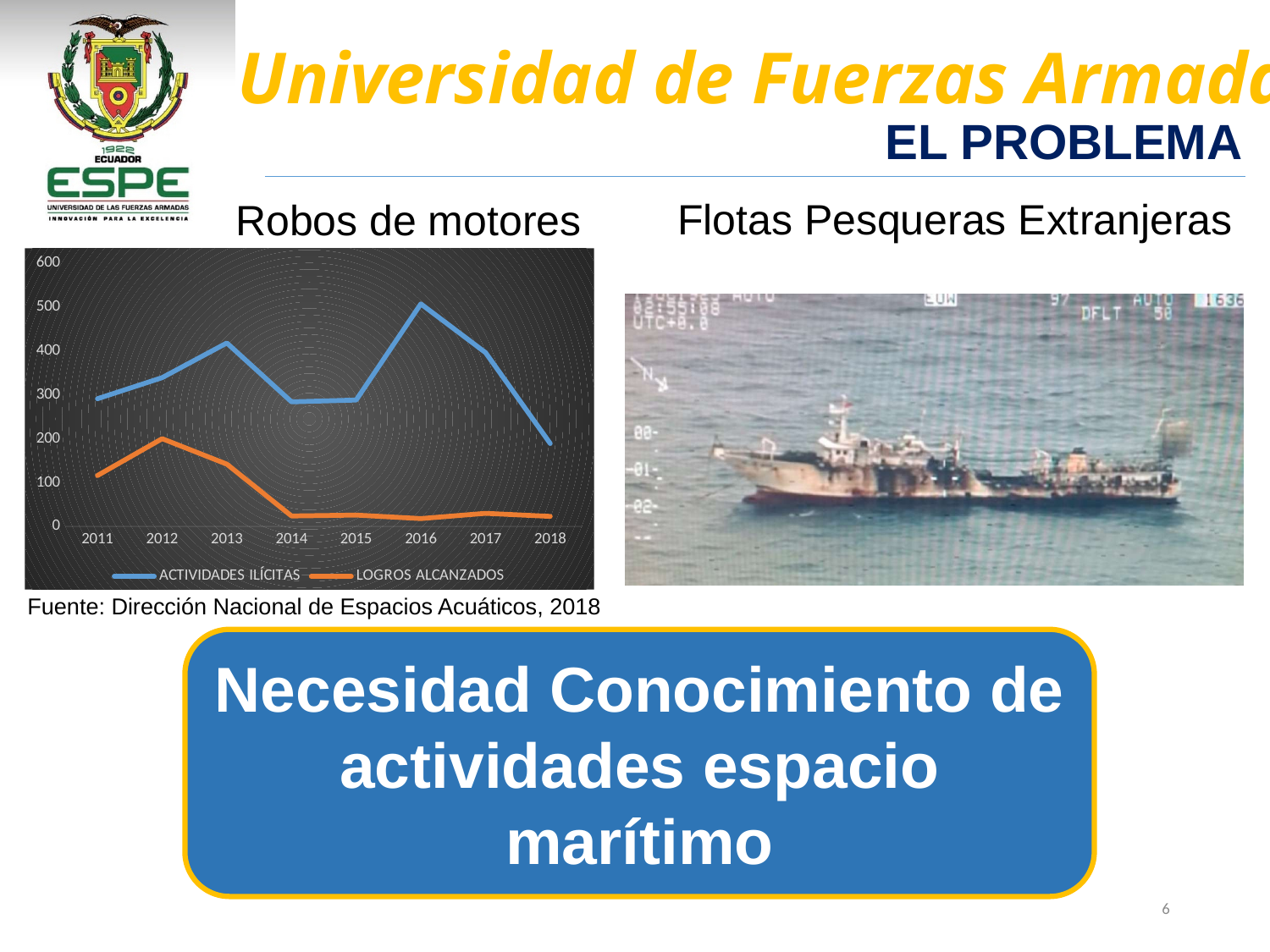
What kind of chart is shown under the heading "Robos de motores"? line chart How many series does the legend of the "Robos de motores" chart list? 2 In the "Robos de motores" chart, does the ACTIVIDADES ILÍCITAS series rise or fall from 2016 to 2018? fall In the "Robos de motores" chart, which series has the larger value in 2016, ACTIVIDADES ILÍCITAS or LOGROS ALCANZADOS? ACTIVIDADES ILÍCITAS In the "Robos de motores" chart, which colour is used for the LOGROS ALCANZADOS series? orange In the "Robos de motores" chart, is the value for LOGROS ALCANZADOS in 2014 greater or less than 100? less In the "Robos de motores" chart, in which year does the ACTIVIDADES ILÍCITAS series reach its highest value? 2016 How many years are shown on the x axis of the "Robos de motores" chart? 8 In the "Robos de motores" chart, in which year does the ACTIVIDADES ILÍCITAS series reach its lowest value? 2018 In the "Robos de motores" chart, is the value for ACTIVIDADES ILÍCITAS in 2016 greater or less than 400? greater In the "Robos de motores" chart, in which year does the LOGROS ALCANZADOS series reach its highest value? 2012 In the "Robos de motores" chart, is the value for ACTIVIDADES ILÍCITAS in 2018 greater or less than 300? less